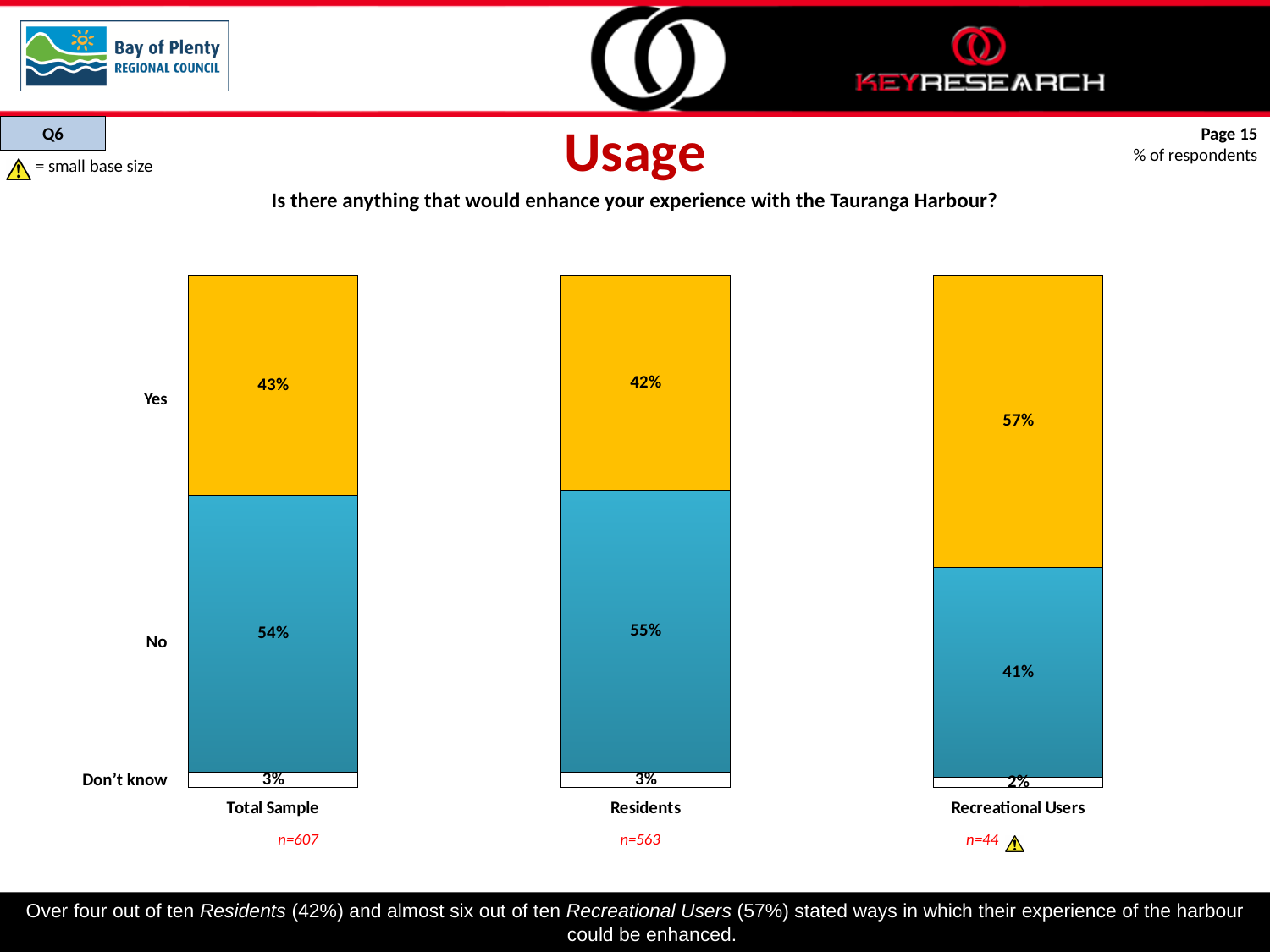
What kind of chart is shown on the slide? Stacked bar chart Is the No percentage larger for the Total Sample or for Recreational Users? Total Sample What percentage of the Total Sample answered Yes? 43% What is the sample size (n) for Residents? n=563 What is the difference between the Yes percentage for Recreational Users and the Yes percentage for Residents? 15% What percentage of Recreational Users answered Yes? 57% What percentage of Recreational Users answered Don't know? 2% Which response category is shown in yellow? Yes Which group has the highest percentage answering Yes? Recreational Users What percentage of Residents answered No? 55% Which group has the lowest percentage answering No? Recreational Users How many groups (bars) are shown in the chart? 3